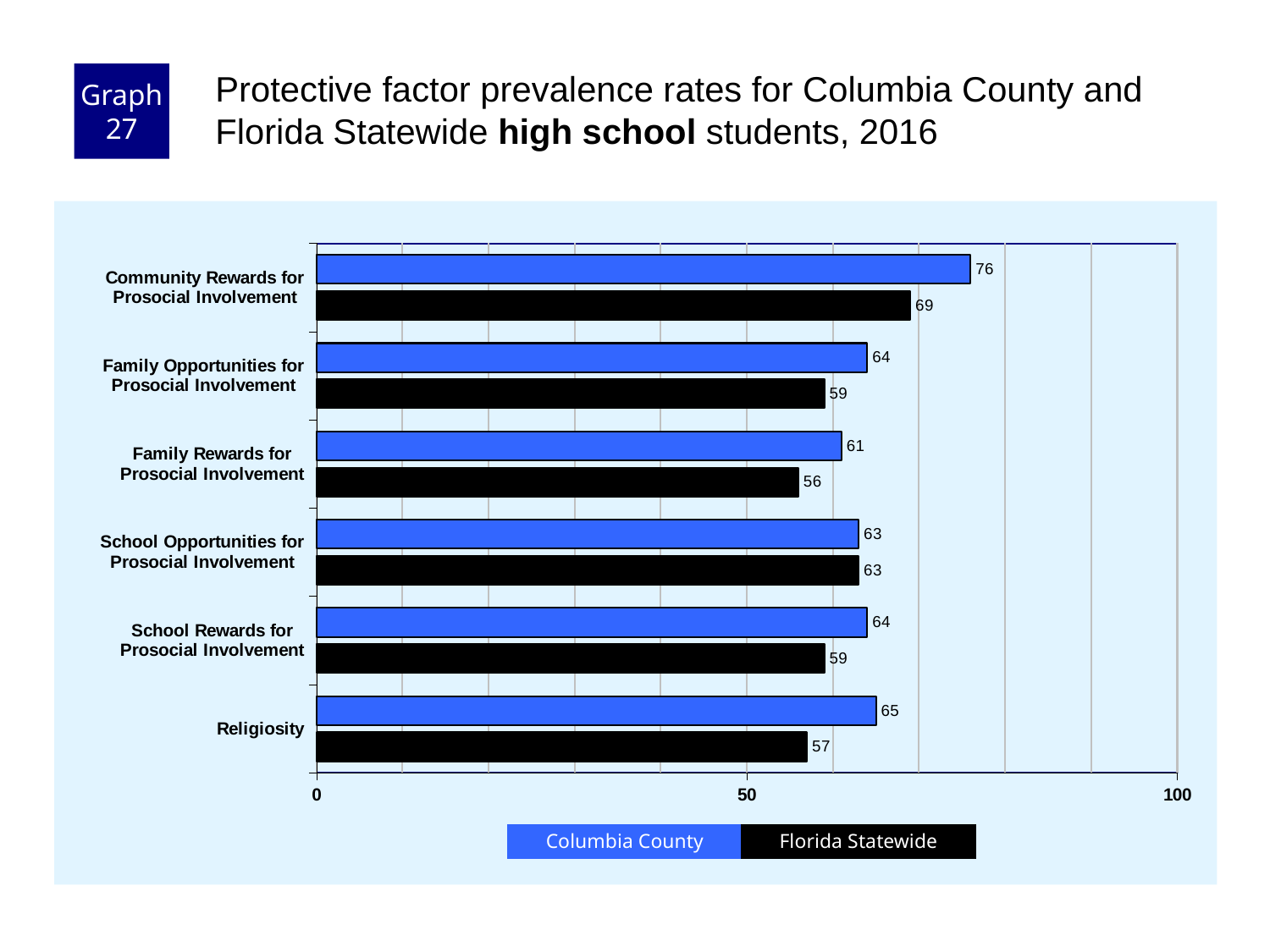
What is the Florida Statewide value for Family Rewards for Prosocial Involvement? 56 Which is larger for Family Opportunities for Prosocial Involvement: the Columbia County value or the Florida Statewide value? Columbia County Which category has the lowest Florida Statewide value? Family Rewards for Prosocial Involvement What kind of chart is shown on the slide? Bar chart What is the difference between the Columbia County and Florida Statewide values for Religiosity? 8 What is the Florida Statewide value for Religiosity? 57 Is the Florida Statewide value for School Rewards for Prosocial Involvement greater or less than 50? greater What is the difference between the Columbia County and Florida Statewide values for Community Rewards for Prosocial Involvement? 7 How many protective factor categories are shown on the chart? 6 Which category has the highest Columbia County value? Community Rewards for Prosocial Involvement What is the Columbia County value for Community Rewards for Prosocial Involvement? 76 How many series does the legend list? 2